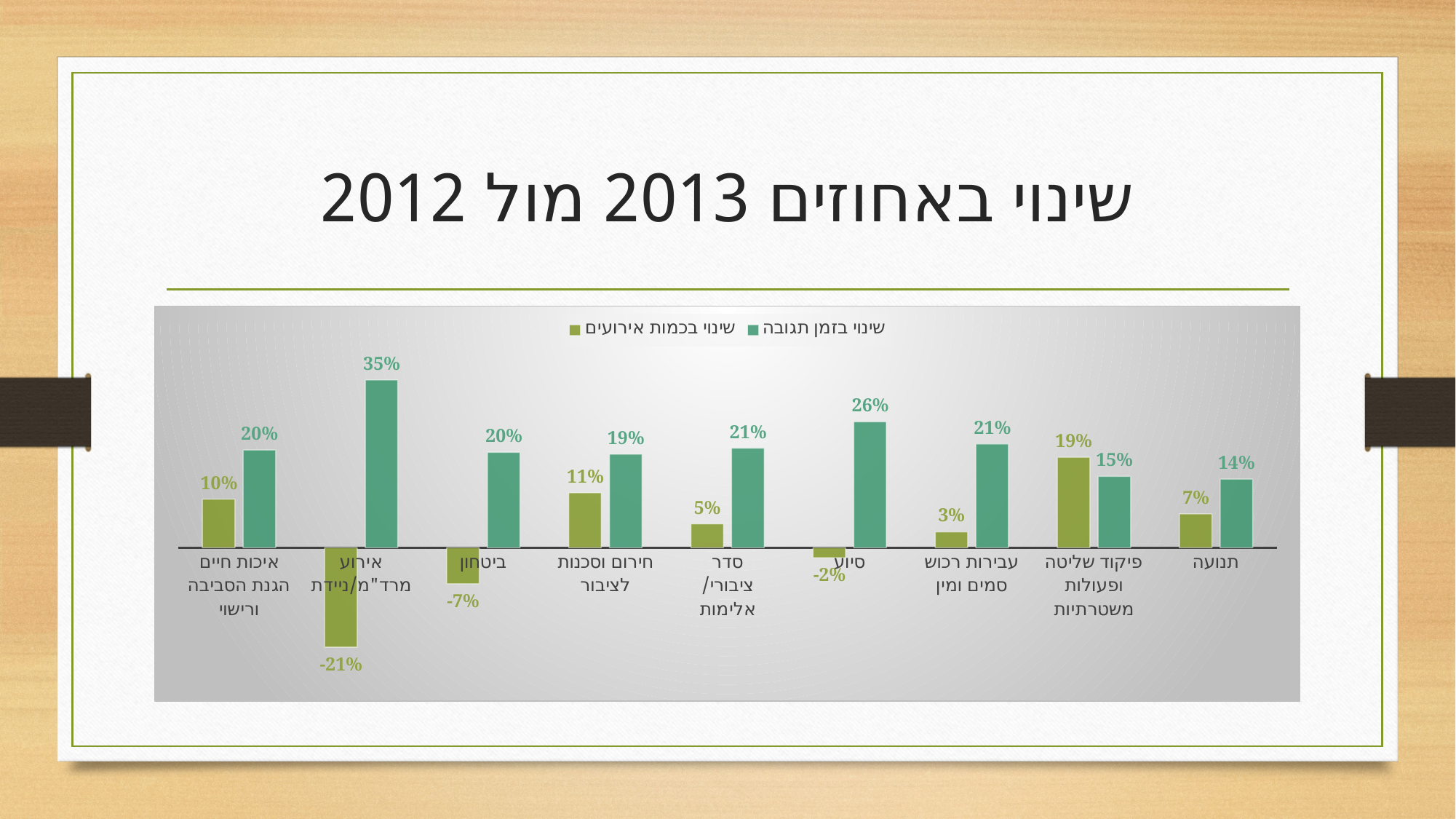
What is the value of שינוי בזמן תגובה for תנועה? 14% What is the difference between the שינוי בזמן תגובה value for סיוע and the שינוי בזמן תגובה value for תנועה? 12% Which category has the highest value for שינוי בזמן תגובה? אירוע מרד"מ/ניידת What is the title of the slide? שינוי באחוזים 2013 מול 2012 What is the value of שינוי בכמות אירועים for פיקוד שליטה ופעולות משטרתיות? 19% For פיקוד שליטה ופעולות משטרתיות, which series has the larger value: שינוי בכמות אירועים or שינוי בזמן תגובה? שינוי בכמות אירועים What kind of chart is shown on the slide? Bar chart What is the value of שינוי בכמות אירועים for ביטחון? -7% What is the value of שינוי בזמן תגובה for אירוע מרד"מ/ניידת? 35% How many series does the legend list? 2 Which category has the lowest value for שינוי בכמות אירועים? אירוע מרד"מ/ניידת How many categories are shown on the x axis? 9